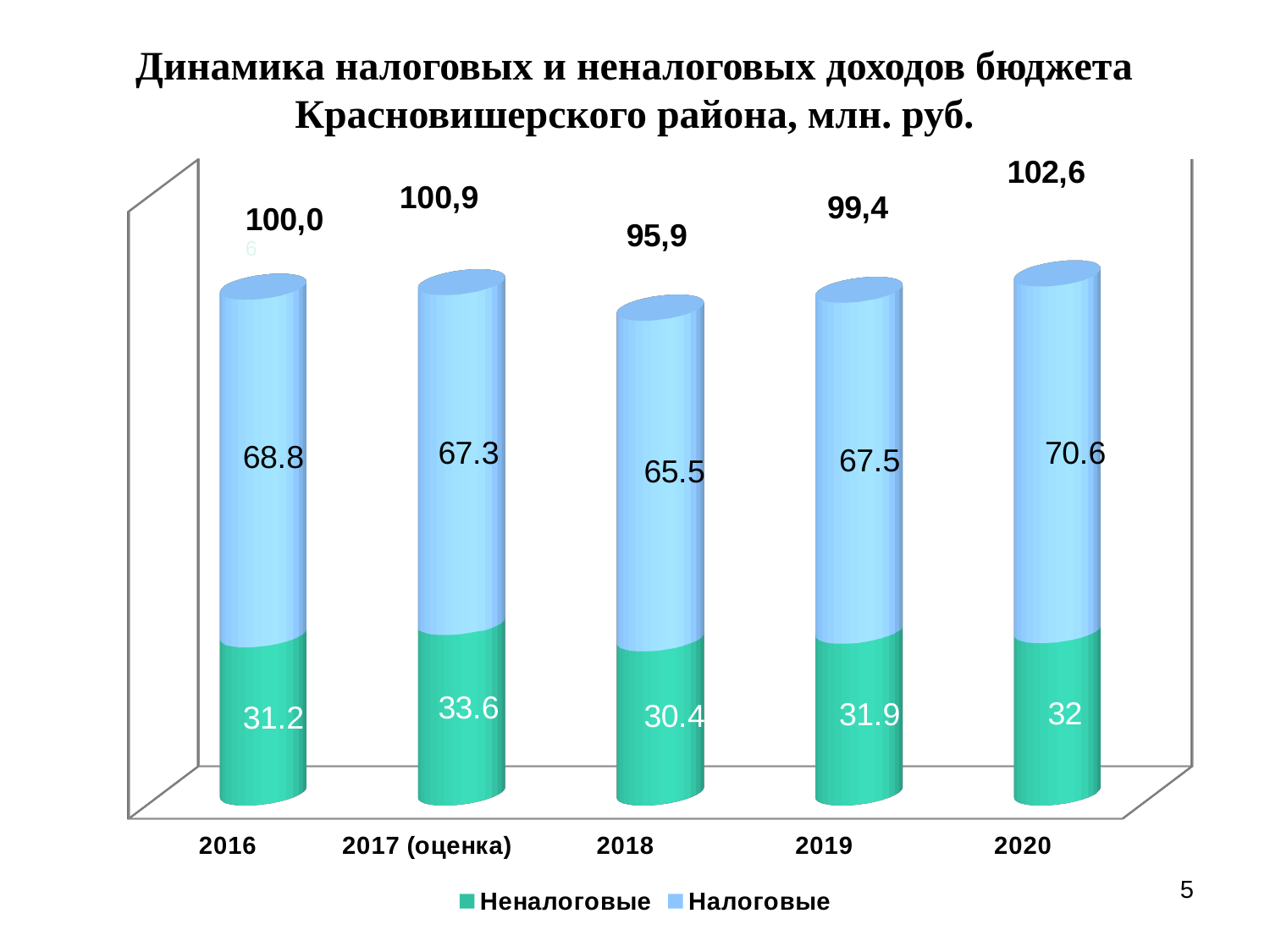
What is the value of Налоговые for 2018? 65.5 What is the value of Налоговые for 2020? 70.6 How many series does the legend list? 2 How many categories are shown on the x axis? 5 Which series is shown in green? Неналоговые Which year has the lowest Неналоговые value? 2018 Which year has the highest Налоговые value? 2020 Which is larger: Неналоговые for 2016 or Неналоговые for 2019? 2019 What is the difference between the Налоговые values for 2020 and 2018? 5.1 What is the value of Неналоговые for 2017 (оценка)? 33.6 What type of chart is shown on the slide? stacked bar chart What is the total of the stacked bar for 2019? 99,4